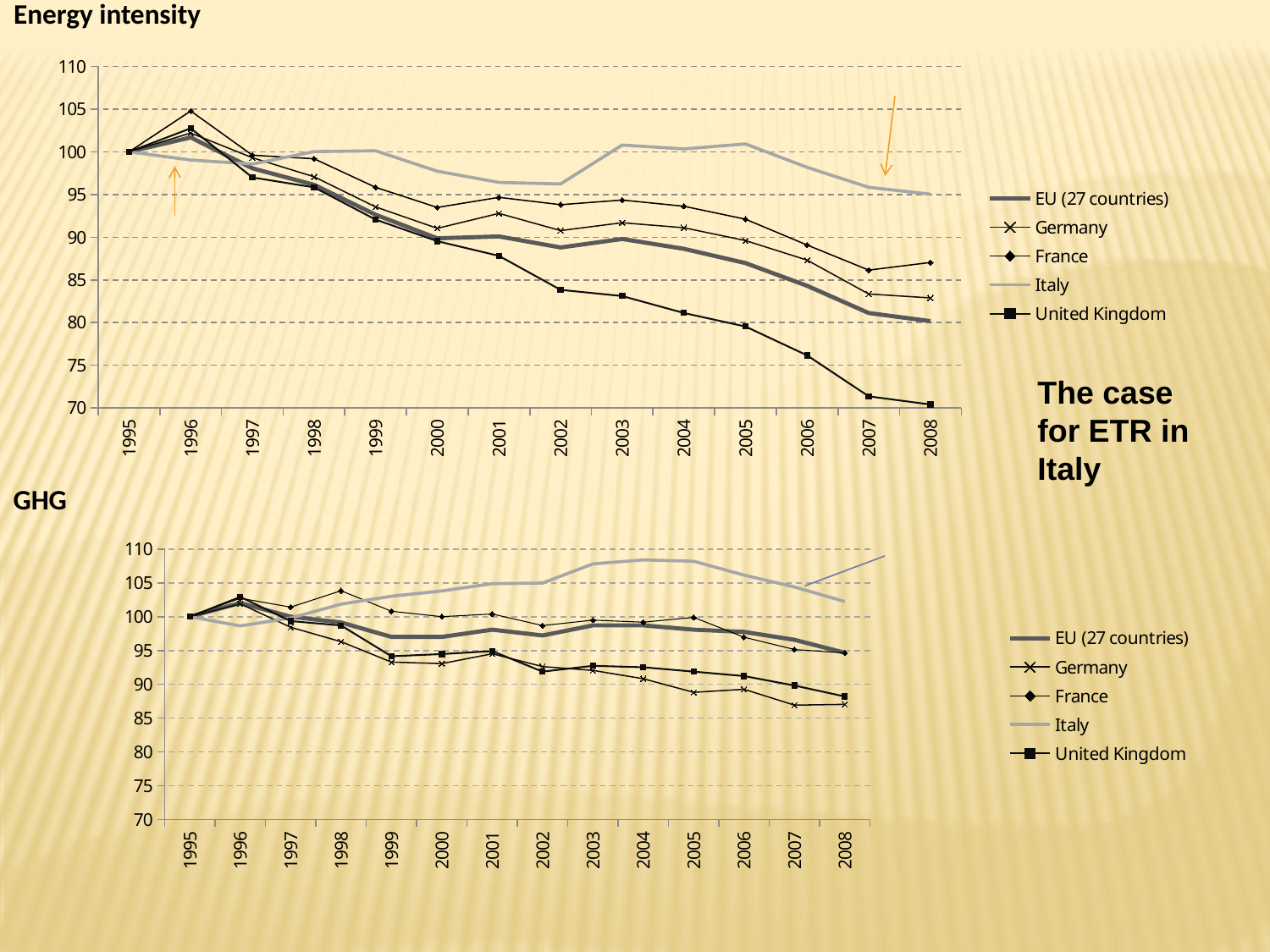
On the Energy intensity chart, does the United Kingdom series rise or fall from 1996 to 2008? fall On the Energy intensity chart, which is larger in 2008, France or Germany? France On the Energy intensity chart, how many series does the legend list? 5 On the GHG chart, what is the value for France in 1995? 100 On the Energy intensity chart, which series has the lowest value in 2008? United Kingdom On the Energy intensity chart, how many years are shown on the x axis? 14 On the GHG chart, is the value for Italy in 2004 greater or less than 105? greater On the Energy intensity chart, is the value for the United Kingdom in 2008 greater or less than 75? less On the GHG chart, which series has the highest value in 2008? Italy On the Energy intensity chart, what is the value for the United Kingdom in 1995? 100 On the Energy intensity chart, which series has the highest value in 2008? Italy On the Energy intensity chart, what kind of chart is shown? line chart